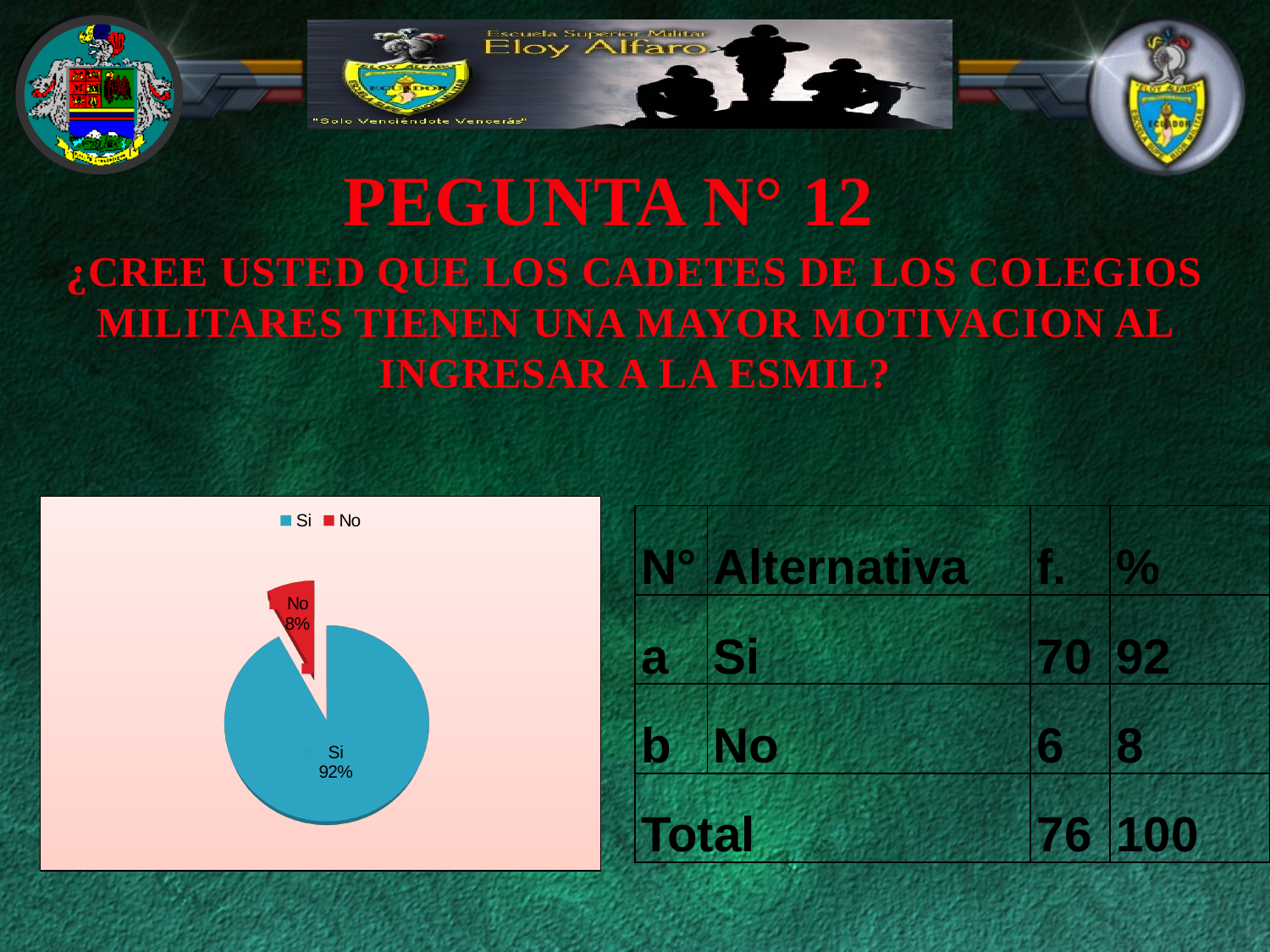
What colour is the "No" slice in the pie chart? red What kind of chart is shown on the slide? pie chart How many slices does the pie chart have? 2 What percentage of the pie chart is the "Si" slice? 92% What colour is the "Si" slice in the pie chart? blue What percentage of the pie chart is the "No" slice? 8% Which slice of the pie chart is the largest? Si Which is larger in the pie chart, the "Si" slice or the "No" slice? Si What is the difference in percentage points between the "Si" and "No" slices of the pie chart? 84 Which slice of the pie chart is the smallest? No How many entries does the legend of the pie chart list? 2